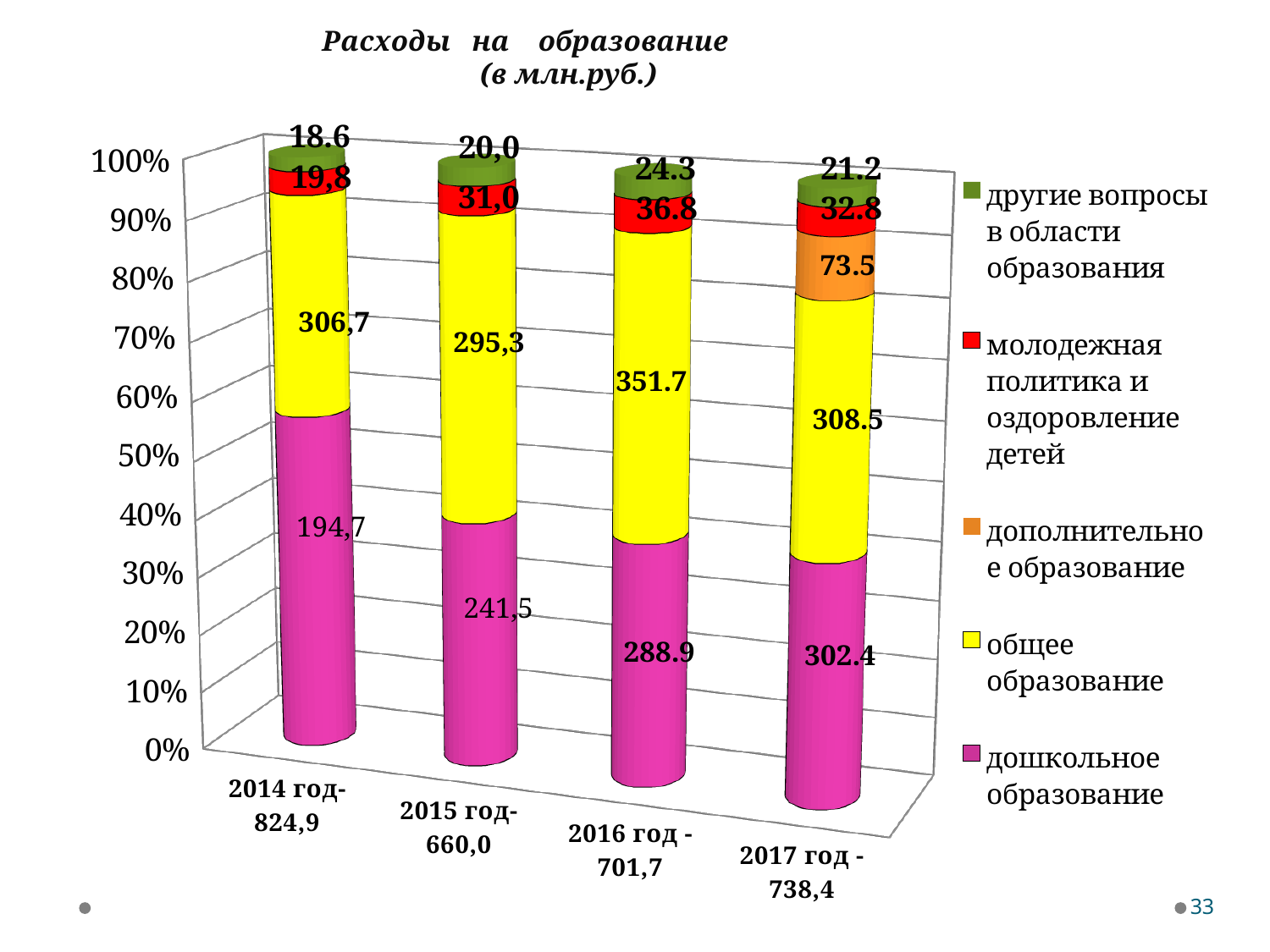
How many series does the legend list? 5 In which year is the value for дошкольное образование the highest? 2017 год What is the value for дополнительное образование in 2017 год? 73.5 What is the value for дошкольное образование in 2014 год? 194,7 What is the difference between the общее образование values for 2016 год and 2015 год? 56.4 What kind of chart is shown on the slide? stacked bar chart Does the value for дошкольное образование rise or fall from 2014 год to 2017 год? rises In 2017 год, which is larger: дошкольное образование or общее образование? общее образование What is the value for молодежная политика и оздоровление детей in 2015 год? 31,0 How many years (categories) are shown on the x axis? 4 In which year is the value for другие вопросы в области образования the lowest? 2014 год What is the value for общее образование in 2016 год? 351.7